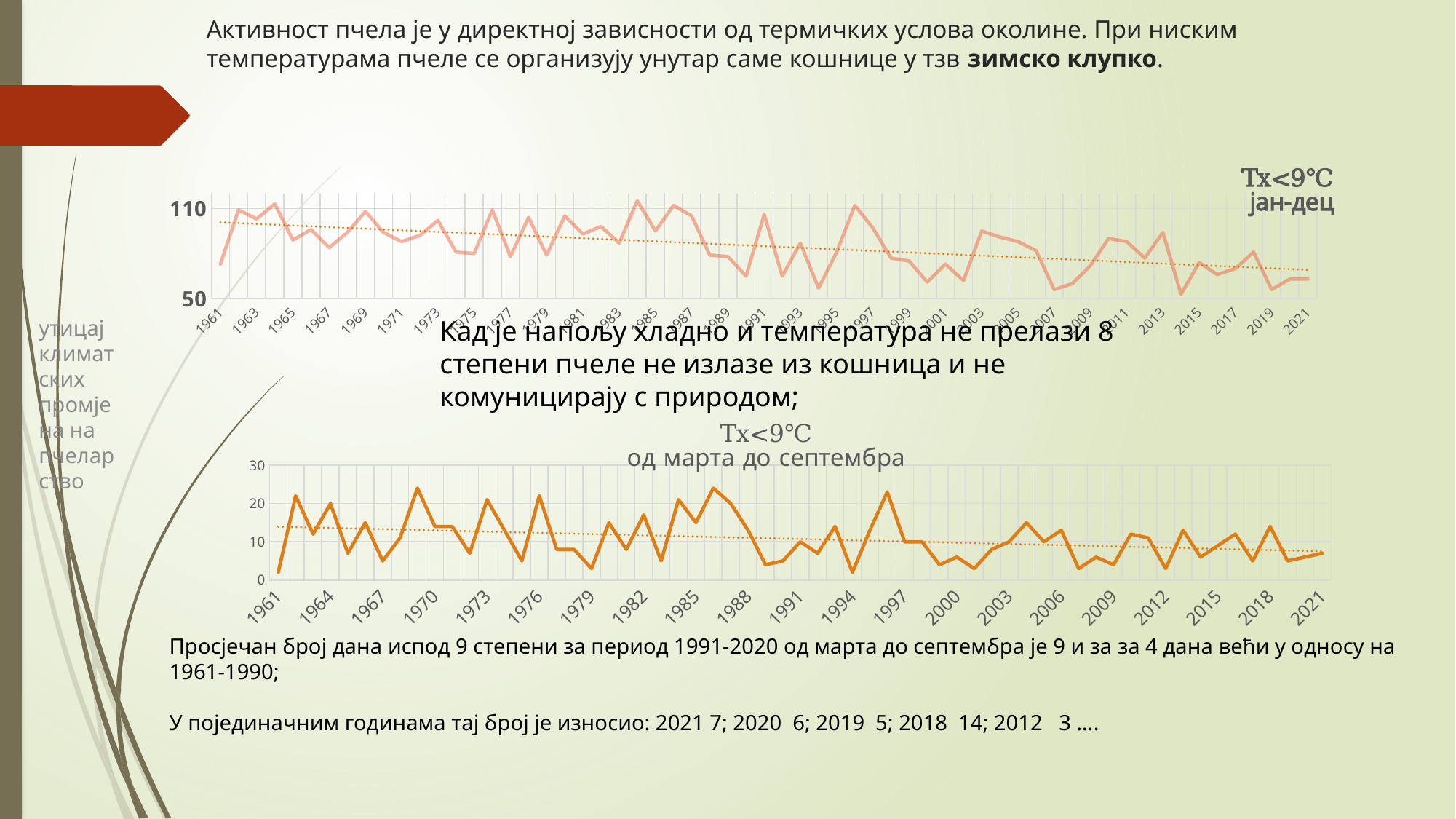
In the top chart (Tx<9°C јан-дец), which year has the larger value, 1985 or 2015? 1985 What kind of chart is the bottom chart titled "Tx<9°C од марта до септембра"? line chart What kind of chart is the top chart titled "Tx<9°C јан-дец"? line chart In the bottom chart (Tx<9°C од марта до септембра), is the value for 1970 greater or less than 20? less In the top chart (Tx<9°C јан-дец), does the dotted trend line rise or fall from 1961 to 2021? fall In the top chart (Tx<9°C јан-дец), is the value for 1961 greater or less than 110? less In the bottom chart (Tx<9°C од марта до септембра), which year has the larger value, 1970 or 1961? 1970 In the bottom chart (Tx<9°C од марта до септембра), does the dotted trend line rise or fall from 1961 to 2021? fall In the bottom chart (Tx<9°C од марта до септембра), is the value for 1961 greater or less than 10? less What is the highest value shown on the y axis of the bottom chart (Tx<9°C од марта до септембра)? 30 What is the first year and the last year shown on the x axis of the bottom chart (Tx<9°C од марта до септембра)? 1961 and 2021